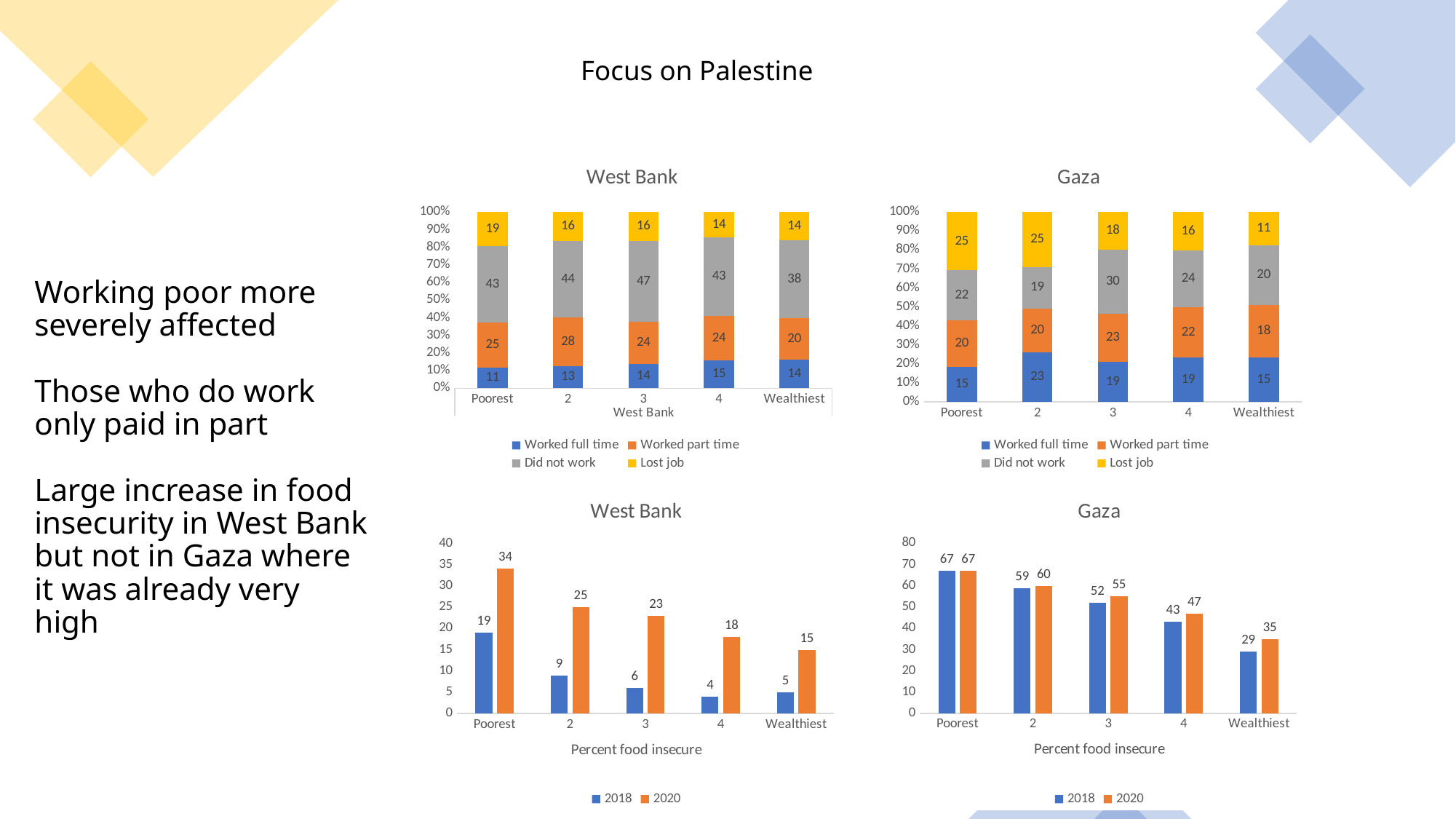
In the bottom-left West Bank chart (Percent food insecure), what is the difference between the 2020 and 2018 values for group 3? 17 In the bottom-right Gaza chart (Percent food insecure), is the 2020 value for group 4 larger or smaller than the 2018 value for group 3? smaller In the top-right Gaza stacked bar chart, which group has the highest value for Worked full time? 2 In the top-right Gaza stacked bar chart, what is the value for Lost job in the Wealthiest group? 11 What type of chart is the bottom-left West Bank chart (Percent food insecure)? bar chart How many series does the legend of the top-left West Bank stacked bar chart list? 4 In the top-left West Bank stacked bar chart, what is the value for Did not work in the Poorest group? 43 How many groups are shown on the x axis of the bottom-right Gaza chart (Percent food insecure)? 5 In the top-left West Bank stacked bar chart, which group has the lowest value for Worked part time? Wealthiest In the bottom-right Gaza chart (Percent food insecure), do the 2018 values rise or fall from Poorest to Wealthiest? fall In the bottom-left West Bank chart (Percent food insecure), what is the 2020 value for the Poorest group? 34 In the bottom-right Gaza chart (Percent food insecure), which group has the lowest 2018 value? Wealthiest